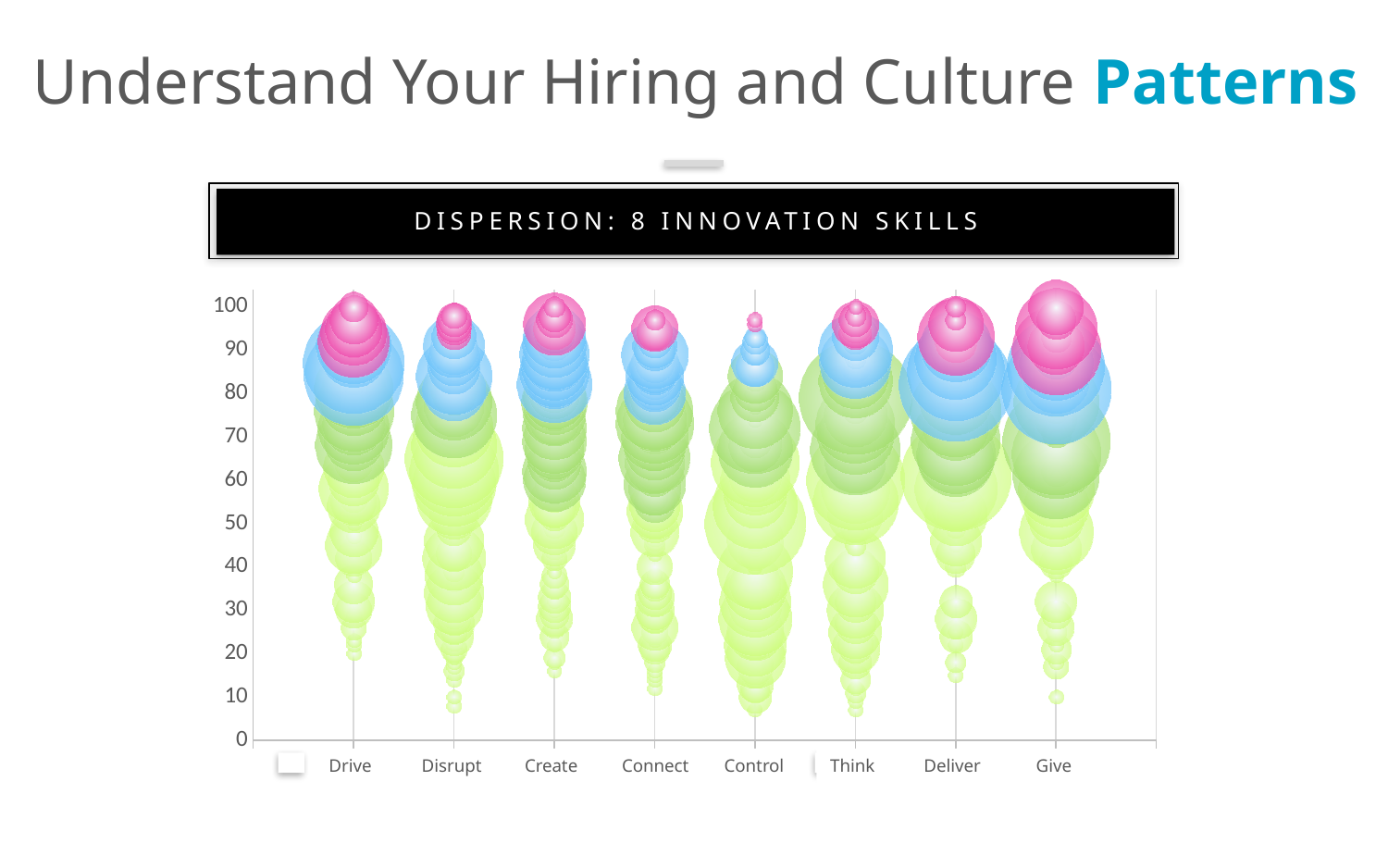
Is the lowest bubble for Think greater or less than 10? less How many categories are shown on the x axis of the chart? 8 Is the lowest bubble for Drive greater or less than 10? greater Is the lowest bubble for Create greater or less than 10? greater What is the maximum value shown on the y axis of the chart? 100 Which category has the smallest pink bubble in the chart? Control Which category is the first one listed on the x axis of the chart? Drive What is the title shown above the chart? DISPERSION: 8 INNOVATION SKILLS What kind of chart is shown on the slide? Bubble chart Which category has the largest pink bubble in the chart? Give